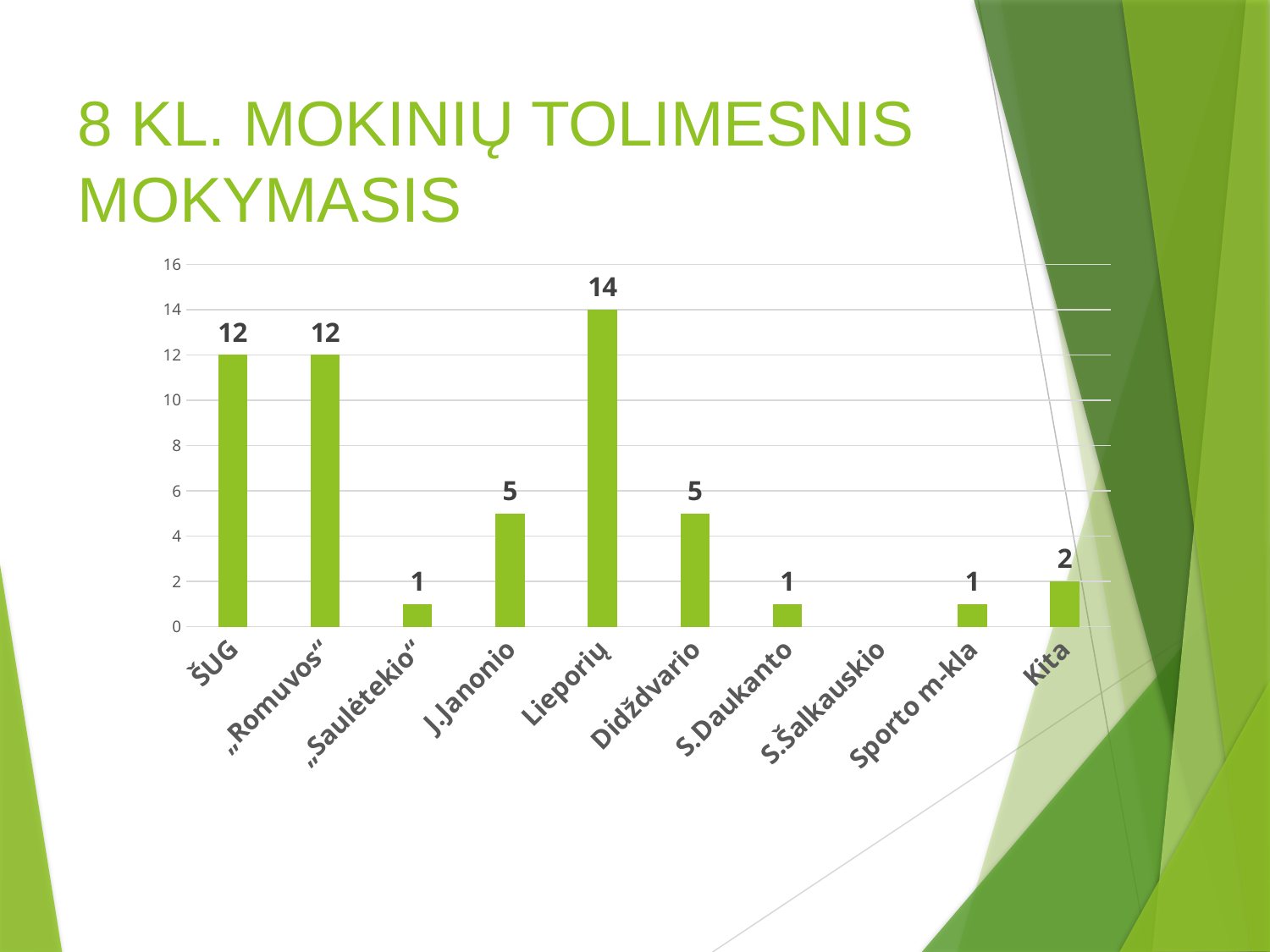
What kind of chart is shown on the slide? bar chart What is the difference between the values for Lieporių and ŠUG? 2 Which is larger, the value for „Romuvos" or the value for Didždvario? „Romuvos" How many categories are shown on the x axis? 10 What is the value for Lieporių? 14 Is the value for Lieporių greater or less than 10? greater What is the title of the slide containing the chart? 8 KL. MOKINIŲ TOLIMESNIS MOKYMASIS What is the value for Kita? 2 Which category has the highest value? Lieporių What is the value for „Saulėtekio"? 1 What is the difference between the values for Didždvario and Kita? 3 What is the value for J.Janonio? 5